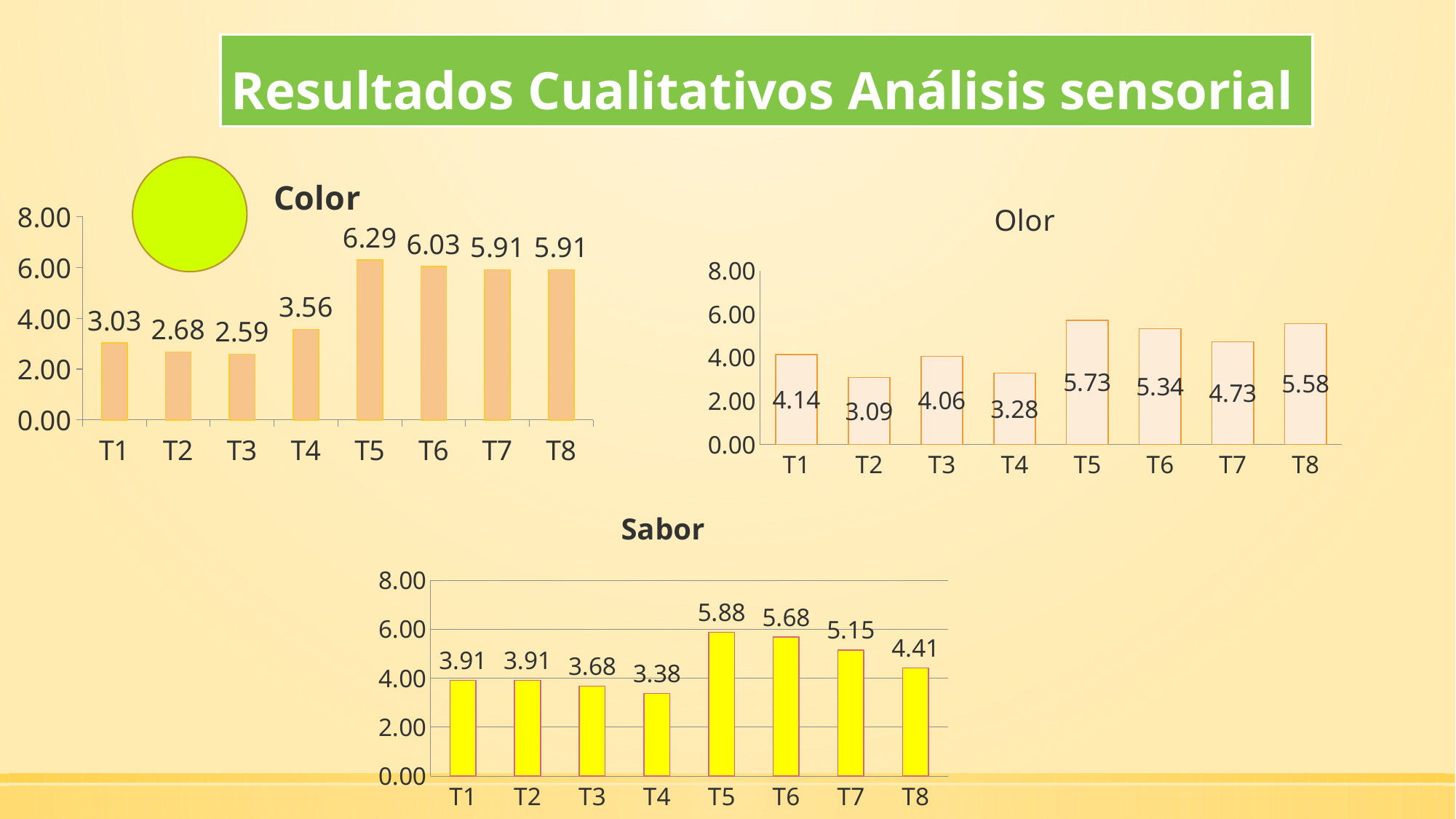
In the Olor chart, which category has the highest value? T5 In the Olor chart, what is the value for T2? 3.09 What kind of chart is the Olor chart? bar chart In the Color chart, what is the value for T5? 6.29 How many categories are shown in the Sabor chart? 8 In the Sabor chart, what is the value for T8? 4.41 In the Olor chart, which is larger, the value for T6 or the value for T8? T8 In the Color chart, which category has the lowest value? T3 In the Color chart, what is the difference between the values for T5 and T1? 3.26 In the Sabor chart, which category has the lowest value? T4 In the Sabor chart, is the value for T5 greater or less than 4.00? greater What colour are the bars in the Sabor chart? yellow